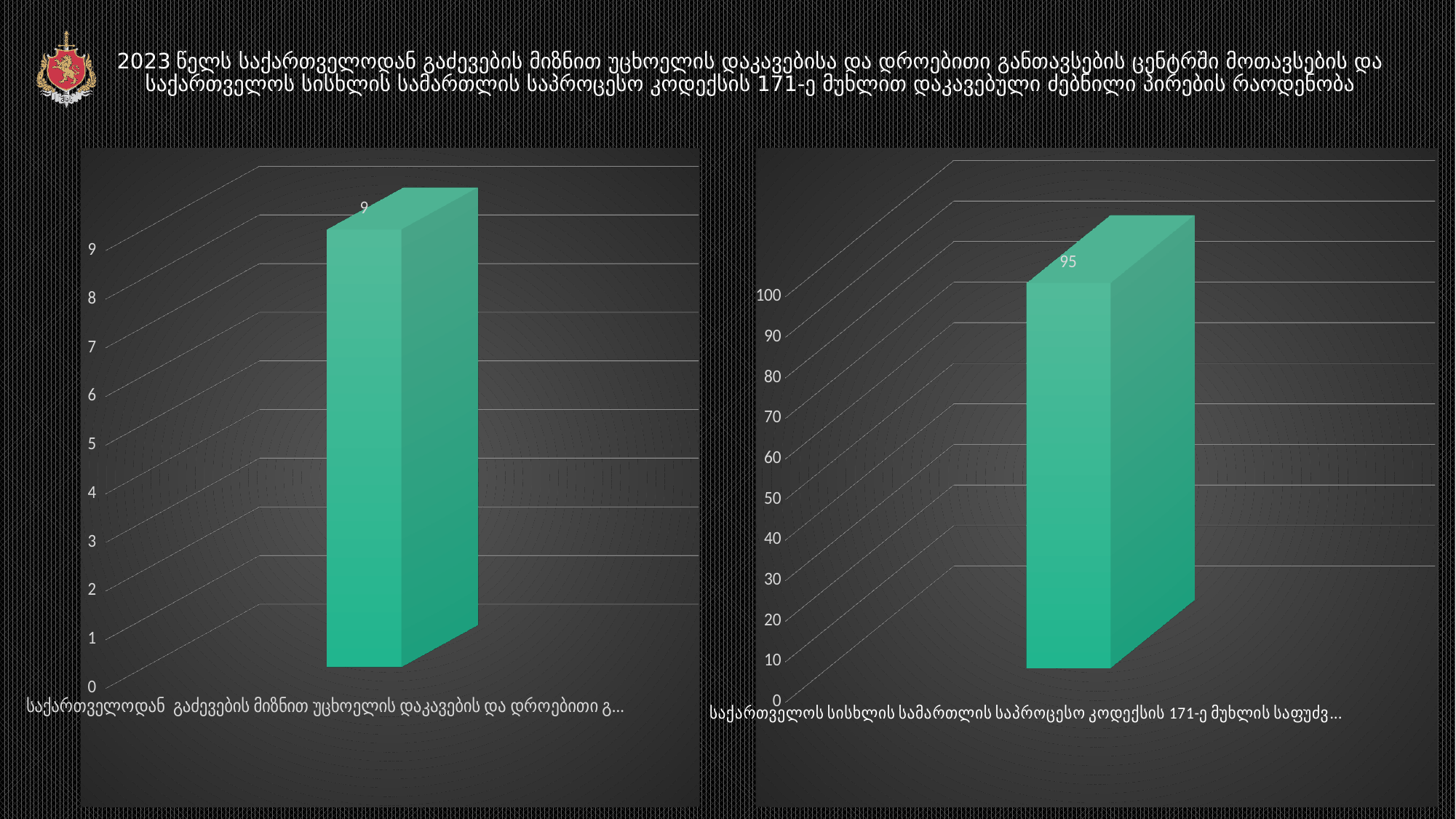
What is the difference between the value on the right chart and the value on the left chart? 86 Which chart shows the larger value, the left chart or the right chart? the right chart What is the highest tick label on the vertical axis of the right chart? 100 How many bars does the left chart have? 1 On the left chart, is the value of the bar greater or less than 5? greater What kind of chart is the right chart? bar chart On the right chart, what value is shown on the bar? 95 What kind of chart is the left chart? bar chart On the right chart, is the value of the bar greater or less than 90? greater What colour are the bars on both charts? green On the left chart, what value is shown on the bar? 9 How many bars does the right chart have? 1